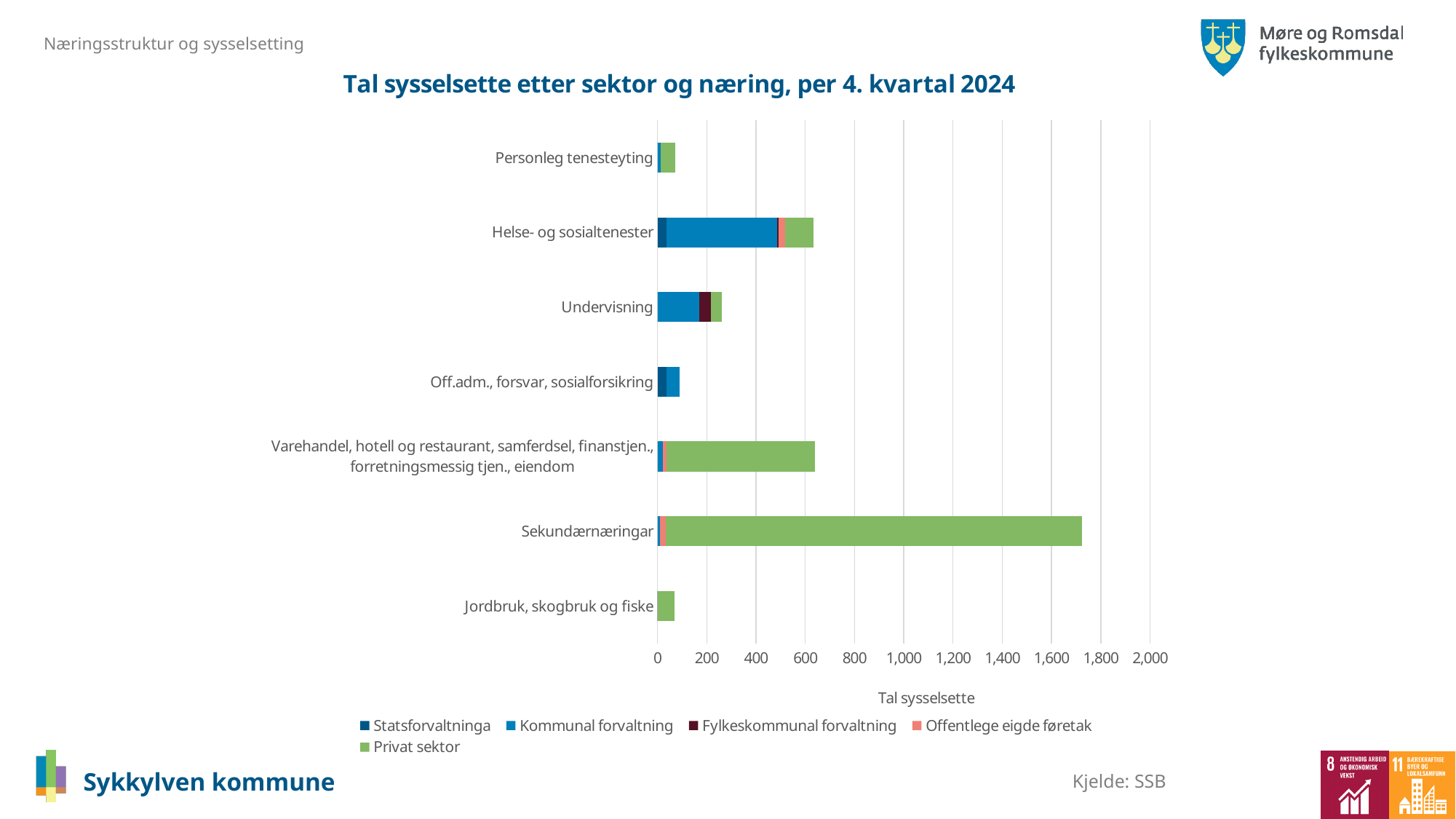
Is the total value for Helse- og sosialtenester greater or less than 400? greater How many series does the legend list? 5 Is the total value for Off.adm., forsvar, sosialforsikring greater or less than 200? less Which category has the longest total bar? Sekundærnæringar Which series is shown in green in the legend? Privat sektor What kind of chart is shown on the slide? Stacked bar chart Is the total value for Personleg tenesteyting greater or less than 200? less How many categories (næringar) are shown on the y axis of the chart? 7 What is the title of the chart? Tal sysselsette etter sektor og næring, per 4. kvartal 2024 Which has the larger total bar, Sekundærnæringar or Helse- og sosialtenester? Sekundærnæringar